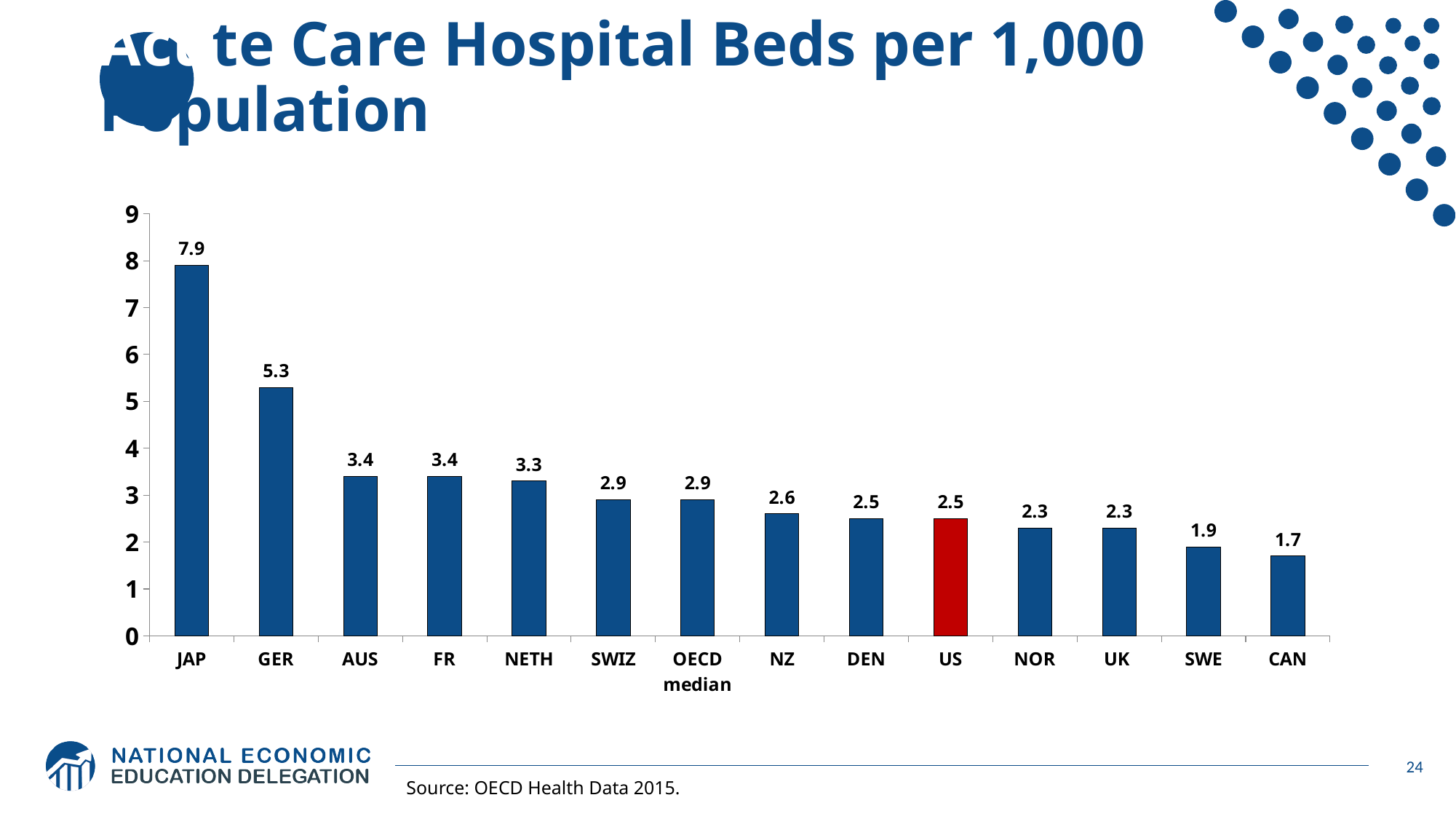
How many categories are shown on the x axis? 14 Is the value for GER greater or less than 5? greater What is the value for JAP? 7.9 Which category has the lowest value? CAN What kind of chart is shown on the slide? bar chart What is the value for the US? 2.5 What is the value for the OECD median? 2.9 What is the difference between the values for JAP and GER? 2.6 What is the difference between the OECD median and the US value? 0.4 Which bar is coloured red rather than blue? US Which category has the highest value? JAP Which is larger, the value for NETH or the value for SWE? NETH